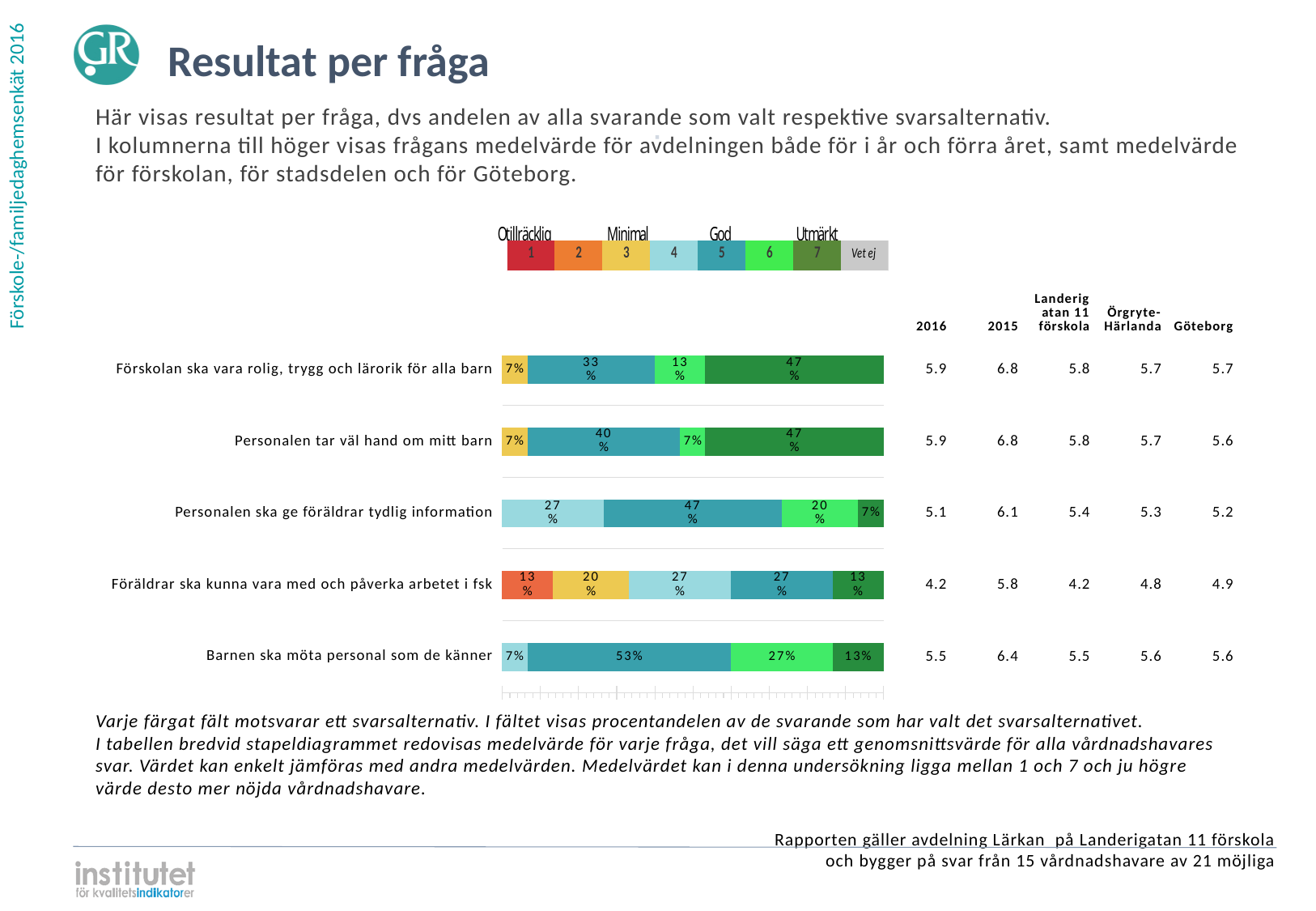
How many response alternatives does the legend above the chart list? 8 Which question has the smallest share of respondents choosing the highest alternative (7, dark green)? Personalen ska ge föräldrar tydlig information What percentage of respondents chose alternative 2 (orange-red) for 'Föräldrar ska kunna vara med och påverka arbetet i fsk'? 13% What is the title of the slide containing the chart? Resultat per fråga How many questions (categories) are shown in the bar chart? 5 What is the 2016 mean value shown for 'Föräldrar ska kunna vara med och påverka arbetet i fsk'? 4.2 What kind of chart is used to show the results per question? Stacked bar chart What percentage of respondents chose alternative 5 for 'Barnen ska möta personal som de känner'? 53% What percentage of respondents chose the highest alternative (7, dark green) for 'Förskolan ska vara rolig, trygg och lärorik för alla barn'? 47% What is the difference between the share choosing alternative 5 and the share choosing alternative 6 for 'Personalen tar väl hand om mitt barn'? 33% What is the total of the segments in the bar for 'Förskolan ska vara rolig, trygg och lärorik för alla barn'? 100% For 'Personalen ska ge föräldrar tydlig information', which is larger: the share choosing alternative 4 or the share choosing alternative 6? Alternative 4 (27%)